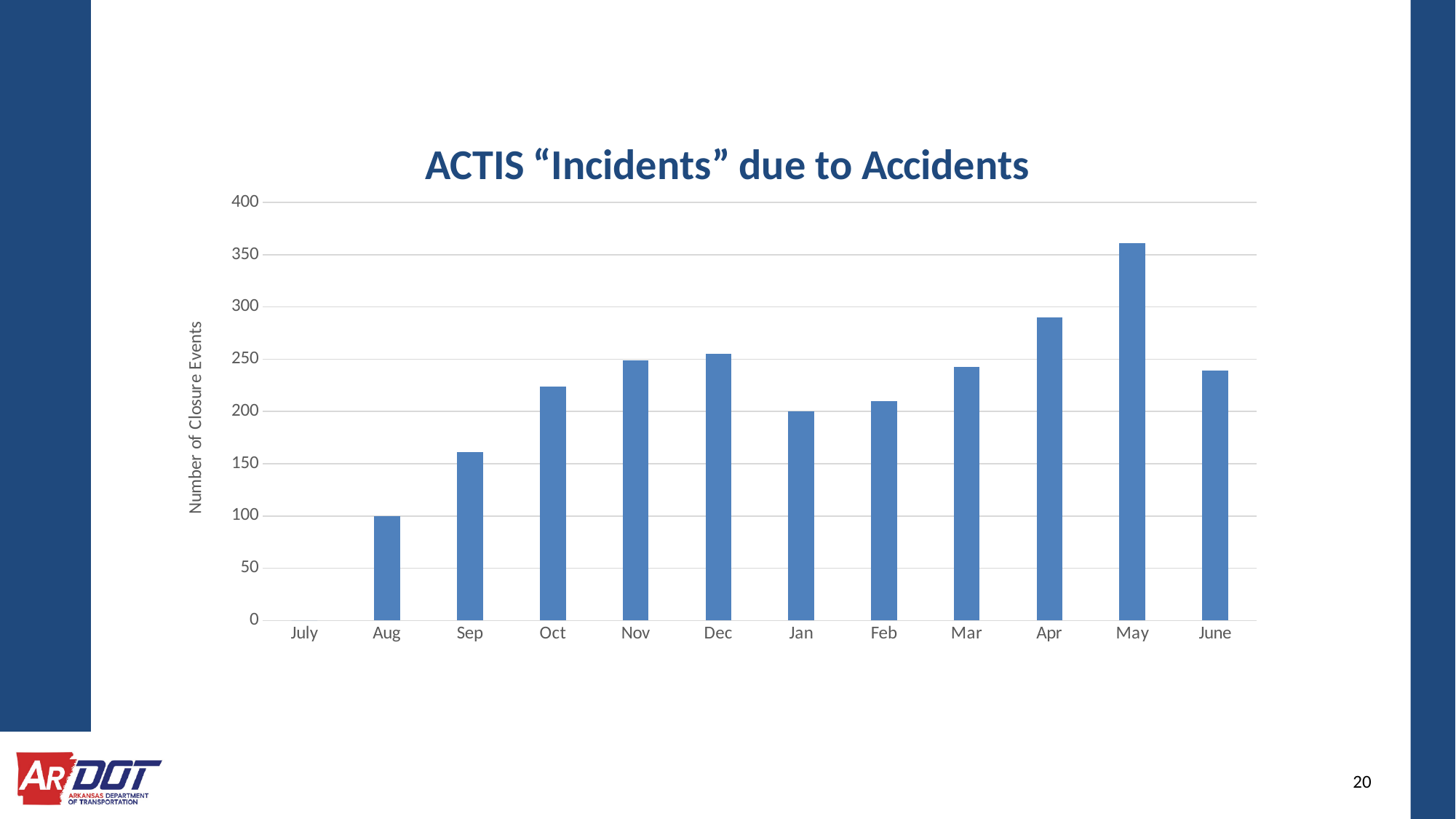
What is the number of closure events for Aug? 100 What kind of chart is shown on the slide? bar chart How many months are listed along the x axis of the chart? 12 Is the value for May greater or less than 350? greater Do the values rise or fall from Aug through Dec? rise What is the title of the chart? ACTIS "Incidents" due to Accidents What is the label on the vertical axis of the chart? Number of Closure Events Which month has more closure events, Apr or Mar? Apr Which month has no bar shown on the chart? July Is the value for Sep greater or less than 150? greater Is the value for Apr greater or less than 300? less Which month has the highest number of closure events? May